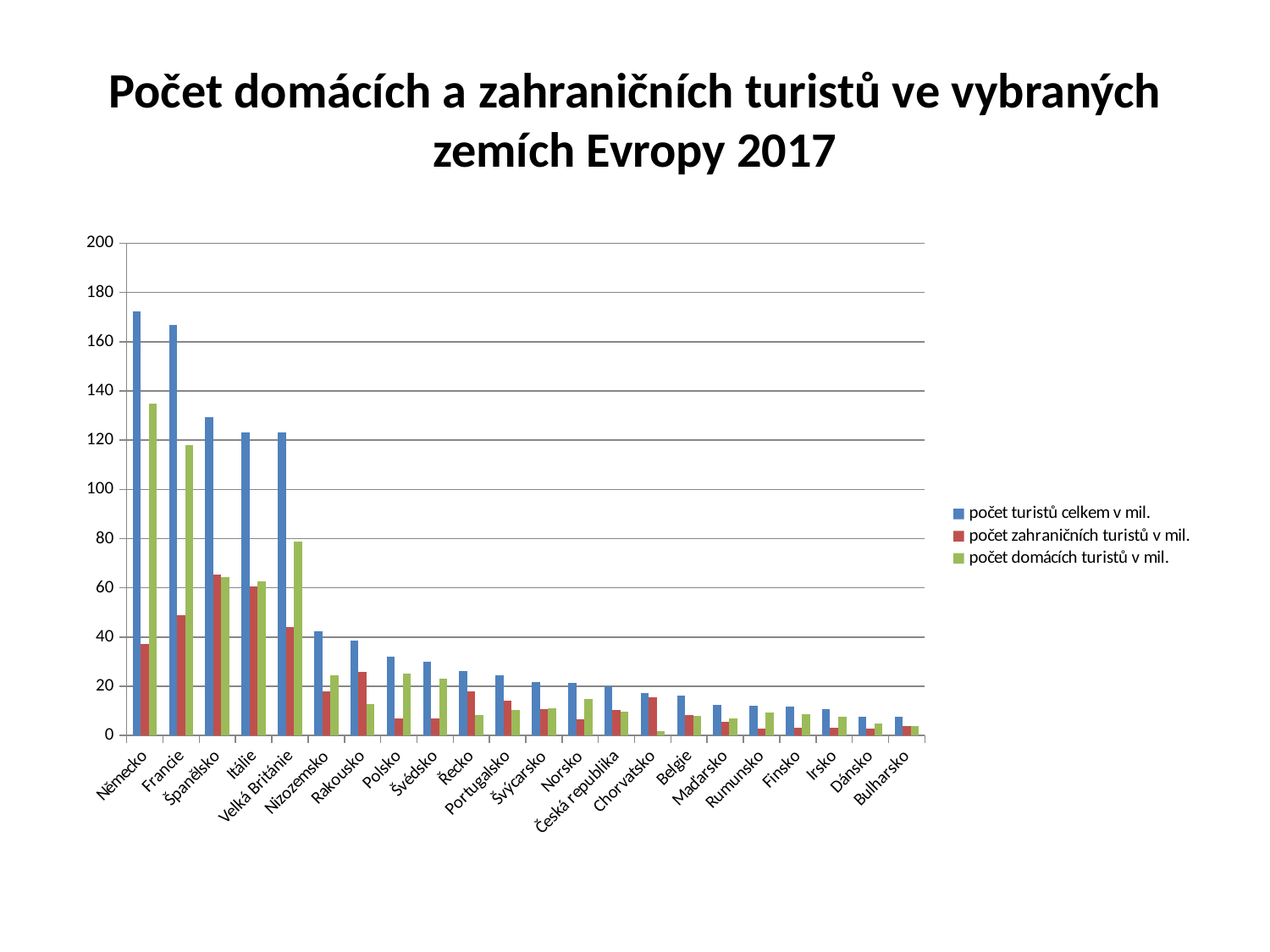
Is the value of počet domácích turistů v mil. for Velká Británie greater or less than 60? greater Is the value of počet domácích turistů v mil. for Francie greater or less than 100? greater For Německo, which is larger: počet zahraničních turistů v mil. or počet domácích turistů v mil.? počet domácích turistů v mil. Is the value of počet turistů celkem v mil. for Bulharsko greater or less than 20? less What kind of chart is shown on the slide? bar chart For Chorvatsko, which is larger: počet zahraničních turistů v mil. or počet domácích turistů v mil.? počet zahraničních turistů v mil. Which country has the highest value for počet turistů celkem v mil.? Německo Do the values of počet turistů celkem v mil. generally rise or fall from left to right along the x axis? fall Which country has the highest value for počet domácích turistů v mil.? Německo How many series does the legend list? 3 How many countries are shown on the x axis of the chart? 22